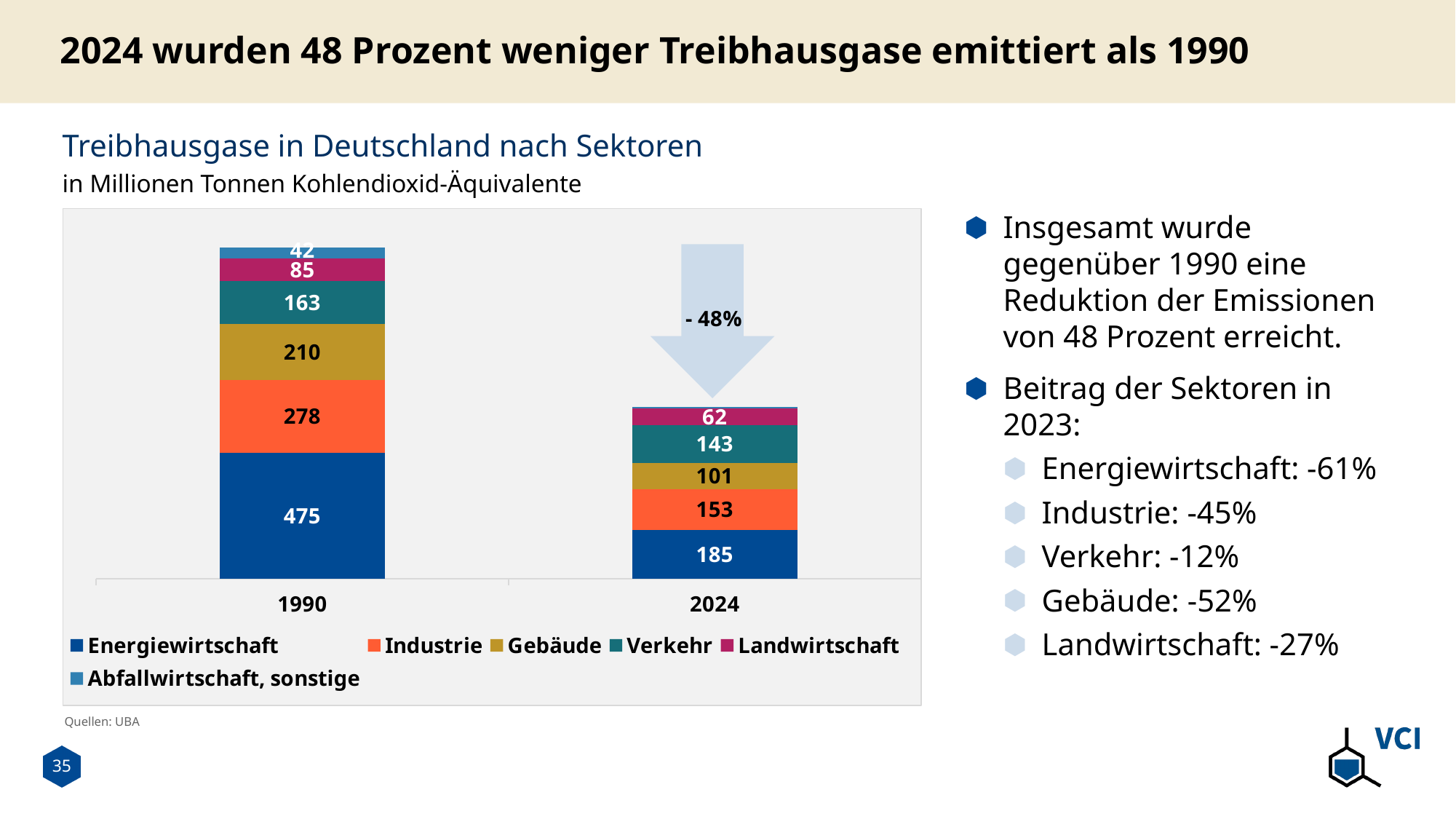
By how much did the value for Energiewirtschaft fall from 1990 to 2024? 290 What is the value for Energiewirtschaft in 1990? 475 Which sector has the lowest labelled value in the 2024 bar? Landwirtschaft What is the total of the 1990 stacked bar? 1253 How many series does the chart legend list? 6 What is the value for Gebäude in 2024? 101 What is the value for Abfallwirtschaft, sonstige in 1990? 42 What type of chart is shown on the slide? Stacked bar chart Which is larger in 2024: Industrie or Verkehr? Industrie Which sector has the highest value in the 1990 bar? Energiewirtschaft What is the value for Verkehr in 2024? 143 How many years (categories) are shown on the x axis of the chart? 2